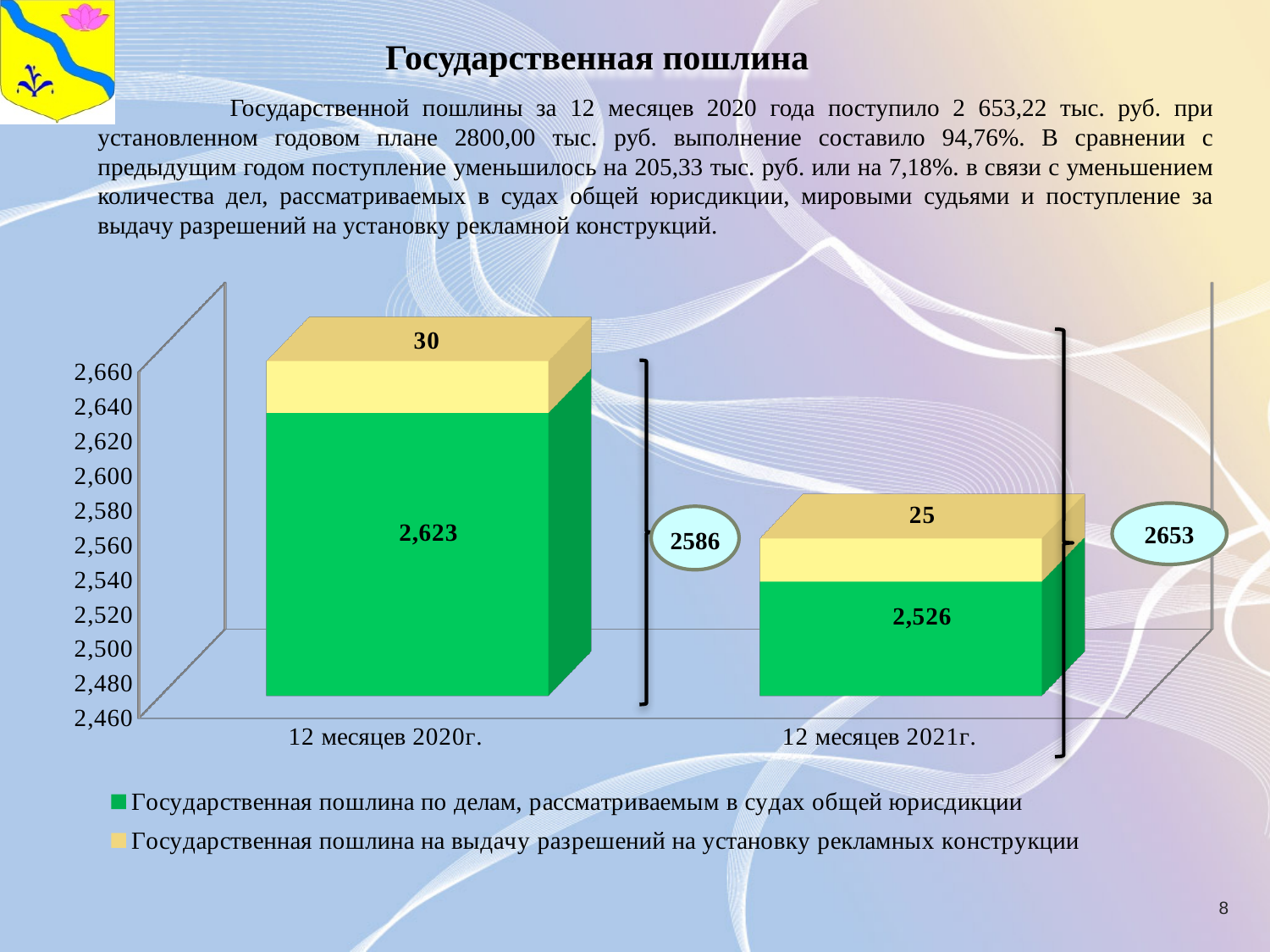
What is the value of 'Государственная пошлина по делам, рассматриваемым в судах общей юрисдикции' for 12 месяцев 2021г.? 2,526 By how much does the value for 'Государственная пошлина по делам, рассматриваемым в судах общей юрисдикции' in 12 месяцев 2020г. exceed that in 12 месяцев 2021г.? 97 What is the value of 'Государственная пошлина на выдачу разрешений на установку рекламных конструкции' for 12 месяцев 2021г.? 25 Which period has the larger value for 'Государственная пошлина по делам, рассматриваемым в судах общей юрисдикции': 12 месяцев 2020г. or 12 месяцев 2021г.? 12 месяцев 2020г. What is the value of 'Государственная пошлина на выдачу разрешений на установку рекламных конструкции' for 12 месяцев 2020г.? 30 What kind of chart is shown on the slide? Stacked bar chart Which colour represents 'Государственная пошлина по делам, рассматриваемым в судах общей юрисдикции' in the chart? Green How many series does the chart legend list? 2 Do the values for 'Государственная пошлина по делам, рассматриваемым в судах общей юрисдикции' rise or fall from 2020 to 2021? Fall How many categories are shown on the x axis of the chart? 2 What is the difference between the 2020 and 2021 values for 'Государственная пошлина на выдачу разрешений на установку рекламных конструкции'? 5 What is the value of 'Государственная пошлина по делам, рассматриваемым в судах общей юрисдикции' for 12 месяцев 2020г.? 2,623